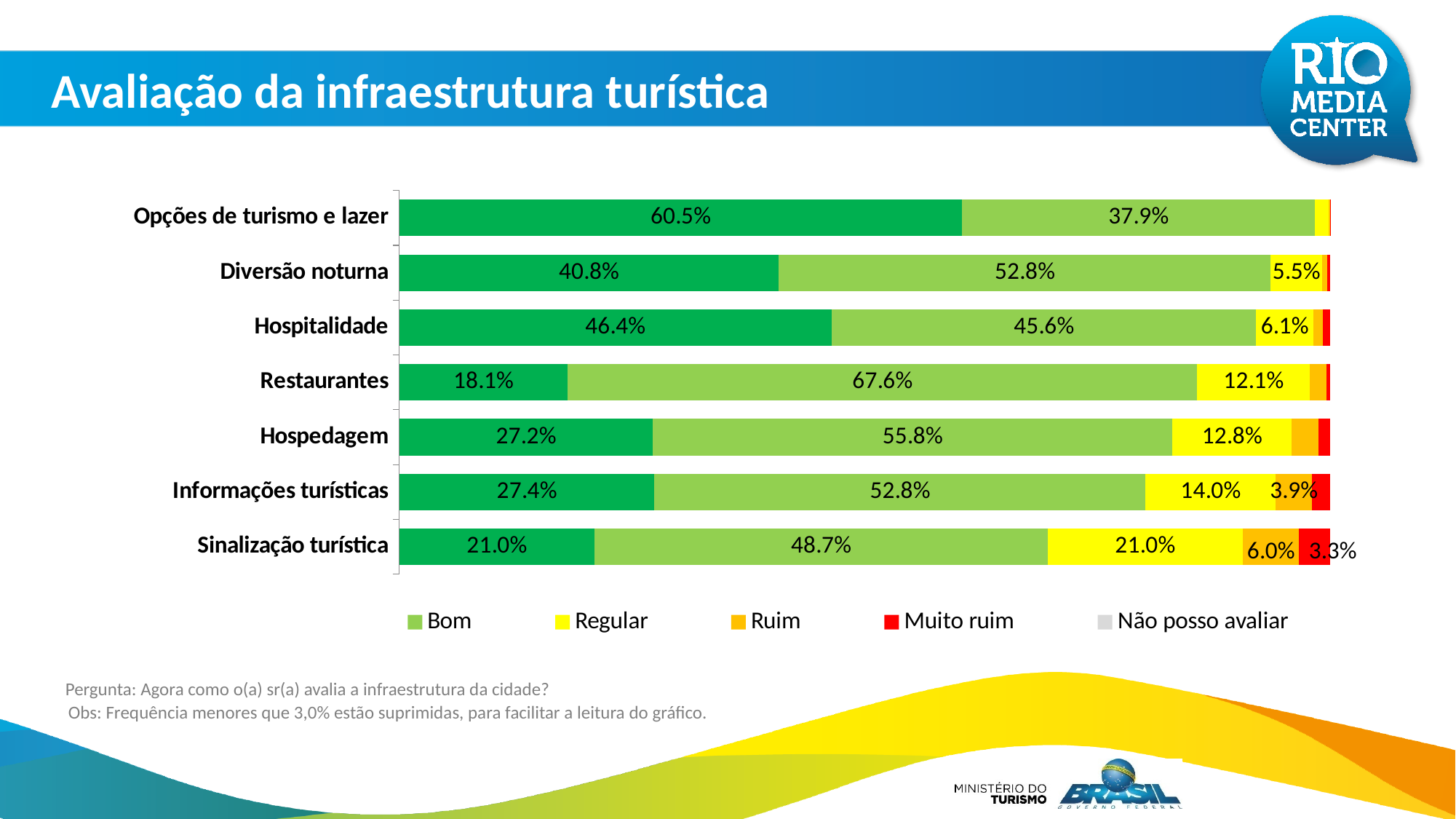
Which has the larger 'Bom' value: Diversão noturna or Hospitalidade? Diversão noturna What is the 'Regular' value for Hospedagem? 12.8% Which category has the lowest 'Bom' value? Opções de turismo e lazer What is the 'Muito ruim' value for Sinalização turística? 3.3% What is the 'Ruim' value for Sinalização turística? 6.0% What kind of chart is shown on the slide? Stacked bar chart What is the 'Bom' value for Restaurantes? 67.6% What is the difference between the 'Regular' value for Sinalização turística and the 'Regular' value for Restaurantes? 8.9 percentage points How many series does the legend list? 5 Which category has the highest 'Bom' value? Restaurantes What colour represents 'Regular' in the legend? Yellow How many categories (infrastructure items) are plotted on the chart? 7